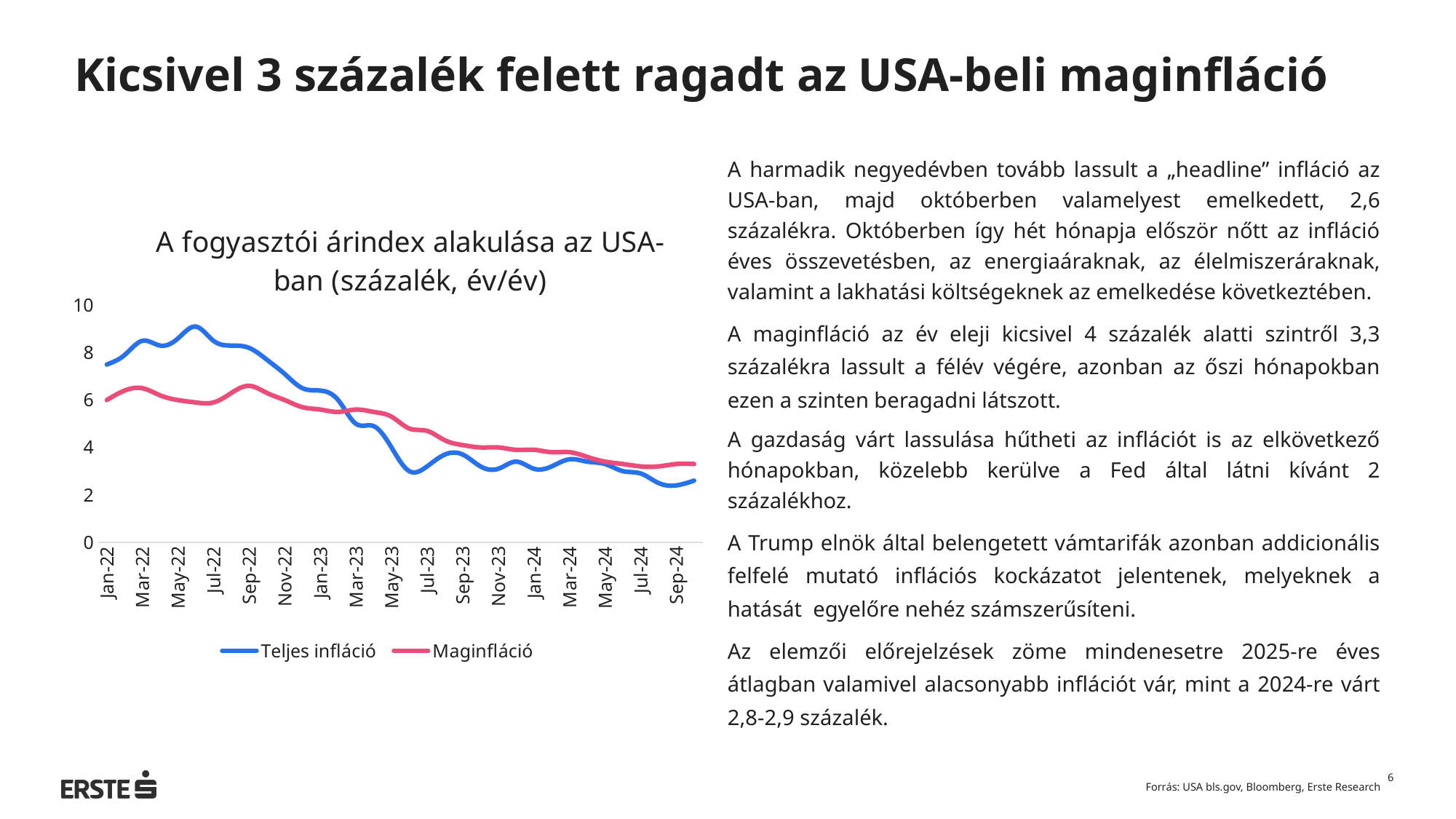
Is the value of Teljes infláció at Jan-22 greater or less than 6? greater Is the value of Maginfláció at Sep-24 greater or less than 2? greater Is the value of Maginfláció at Jan-22 greater or less than 4? greater Does the Teljes infláció line rise or fall between Jan-23 and Sep-24? Fall Which colour is used for the Maginfláció line? Pink What kind of chart is shown on the slide? Line chart At Jan-22, which series has the higher value, Teljes infláció or Maginfláció? Teljes infláció How many month labels are shown on the x axis? 17 How many series does the chart's legend list? 2 At Sep-24, which series has the higher value, Teljes infláció or Maginfláció? Maginfláció What are the two series named in the chart's legend? Teljes infláció and Maginfláció